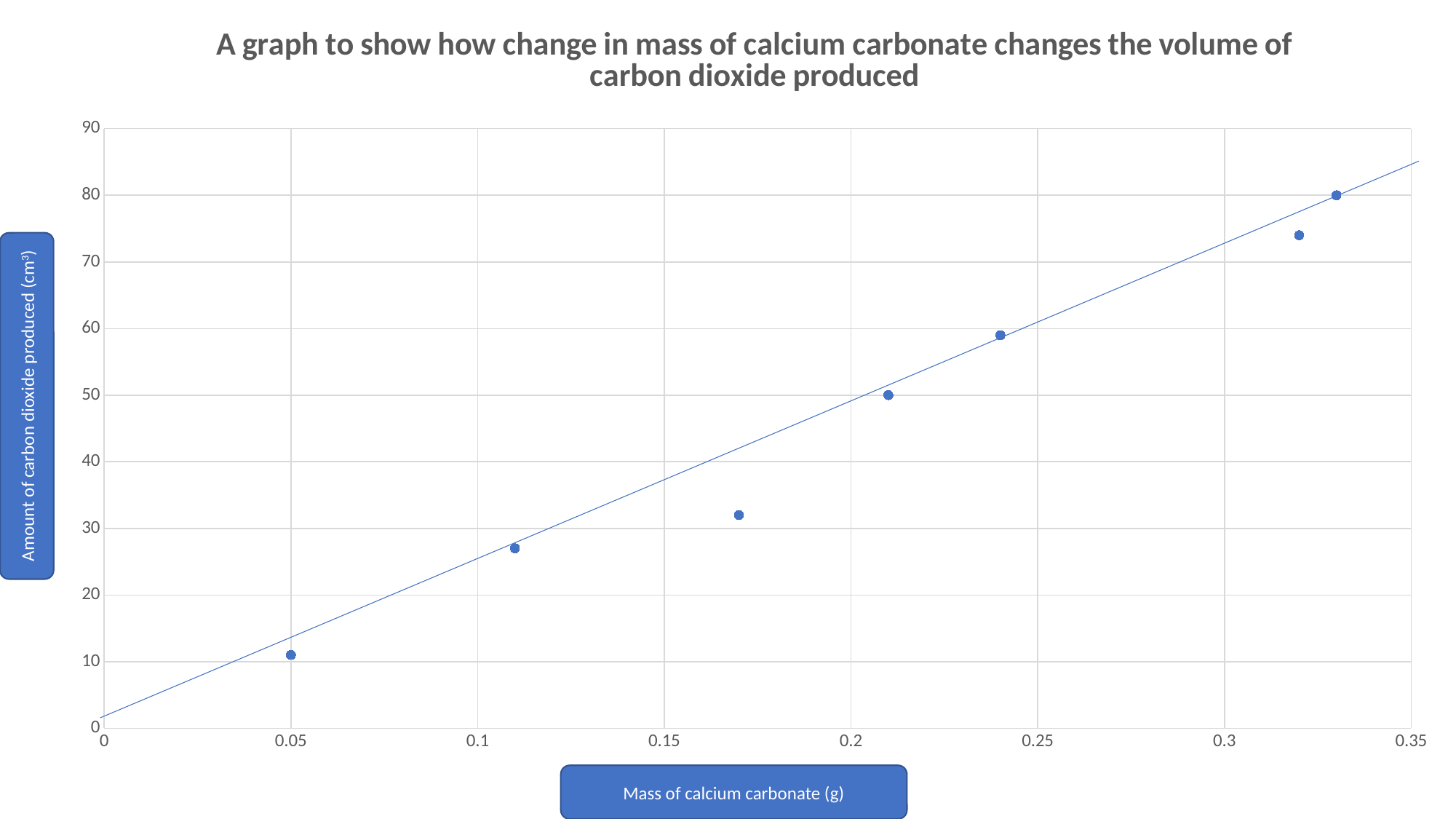
Is the volume of carbon dioxide produced for the point at about 0.11 g greater or less than 20? greater What kind of chart is shown on the slide? scatter chart Is the volume of carbon dioxide produced for the point at about 0.24 g greater or less than 50? greater What is the title of the chart? A graph to show how change in mass of calcium carbonate changes the volume of carbon dioxide produced Do the plotted values rise or fall as the mass of calcium carbonate increases? rise Which point has the highest volume of carbon dioxide produced: the one at about 0.33 g or the one at about 0.24 g? the one at about 0.33 g What is the label of the x axis? Mass of calcium carbonate (g) What is the maximum value shown on the y axis? 90 How many data points are plotted on the chart? 7 Is the volume of carbon dioxide produced for the point at about 0.32 g greater or less than 70? greater